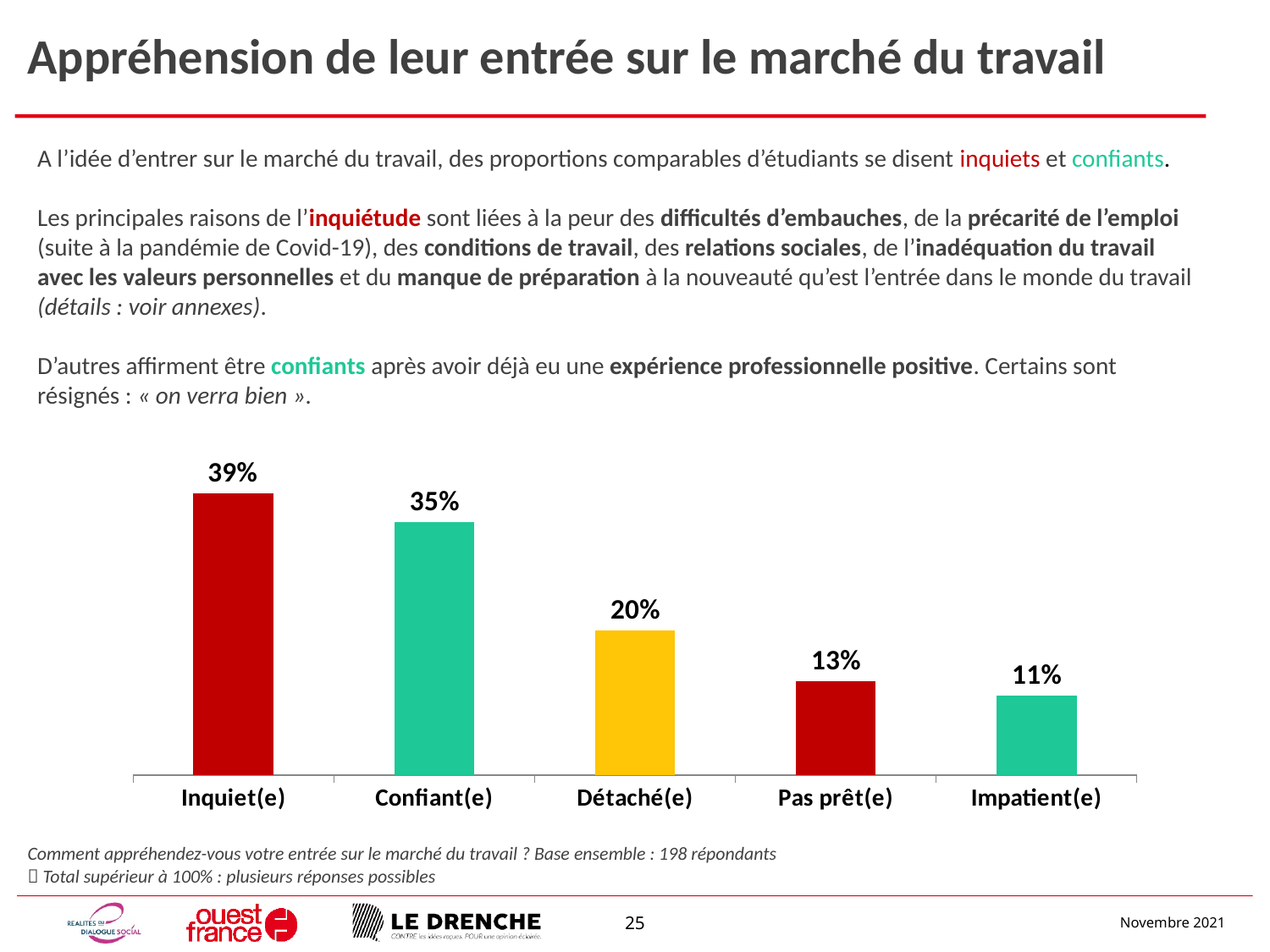
What is the value for Détaché(e)? 20% Which category has the highest value? Inquiet(e) What kind of chart is shown on the slide? Bar chart Which is larger, the value for Détaché(e) or the value for Pas prêt(e)? Détaché(e) Do the values rise or fall from left to right along the x axis? Fall What is the value for Confiant(e)? 35% What is the value for Pas prêt(e)? 13% Which category has the lowest value? Impatient(e) How many categories are shown in the chart? 5 What is the value for Impatient(e)? 11% What is the value for Inquiet(e)? 39% What is the difference between the values for Inquiet(e) and Confiant(e)? 4%